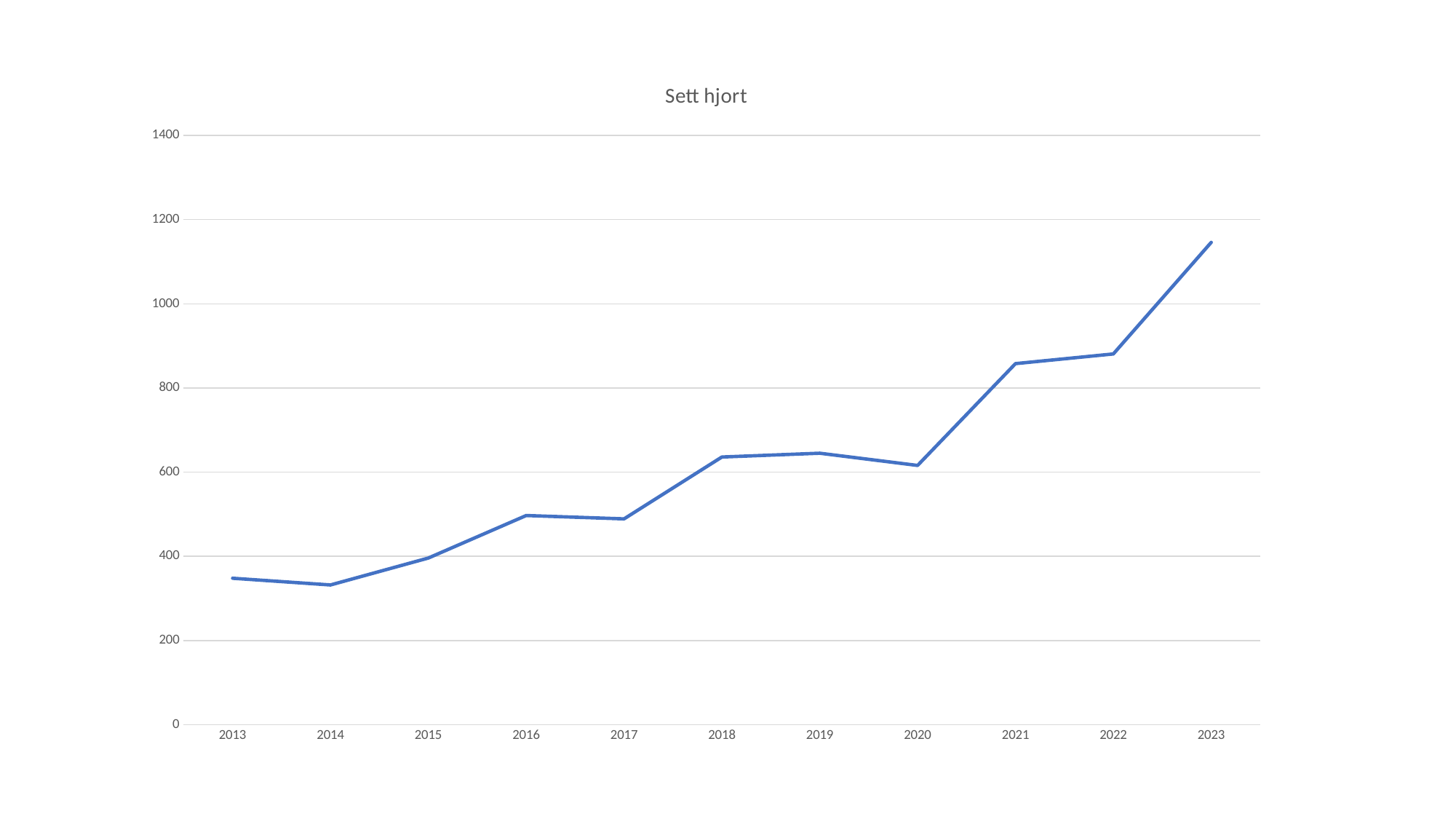
Is the value for 2021 greater or less than 800? greater Which year has the lowest value? 2014 Is the value for 2016 greater or less than 600? less Which year has the highest value? 2023 What kind of chart is shown on the slide? line chart How many years are plotted along the x axis? 11 Which is larger, the value for 2016 or the value for 2014? 2016 Overall, do the values rise or fall from 2013 to 2023? rise What is the title of the chart? Sett hjort Which is larger, the value for 2021 or the value for 2018? 2021 Is the value for 2013 greater or less than 400? less